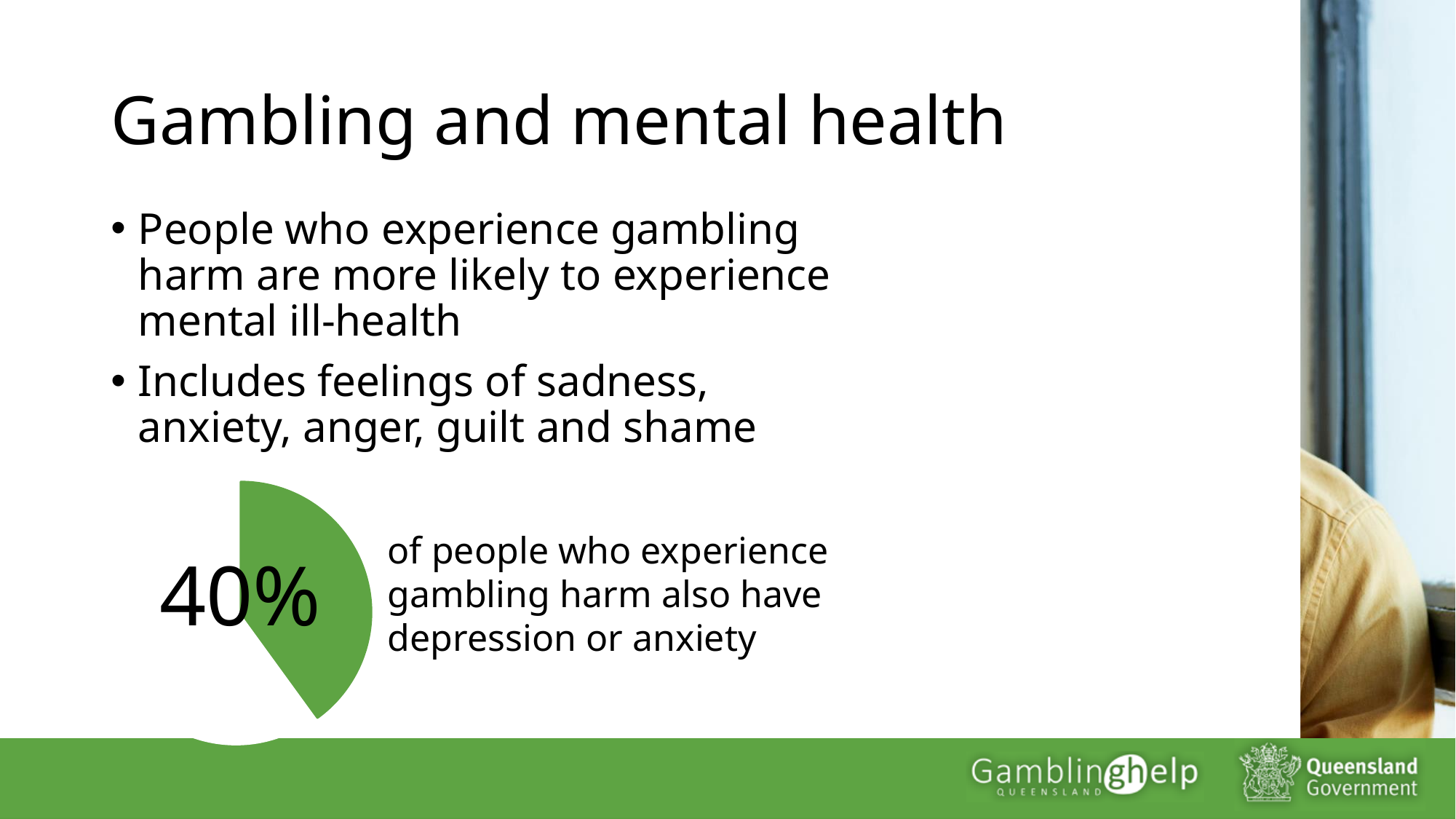
What does the 40% slice of the pie chart represent? people who experience gambling harm who also have depression or anxiety What share of the pie does the green slice represent? 40% What percentage is printed on the pie chart? 40% According to the pie chart, what percentage of people who experience gambling harm also have depression or anxiety? 40% What kind of chart is shown on the slide? pie chart Is the value shown on the pie chart greater or less than 50%? less What colour is the highlighted slice of the pie chart? green